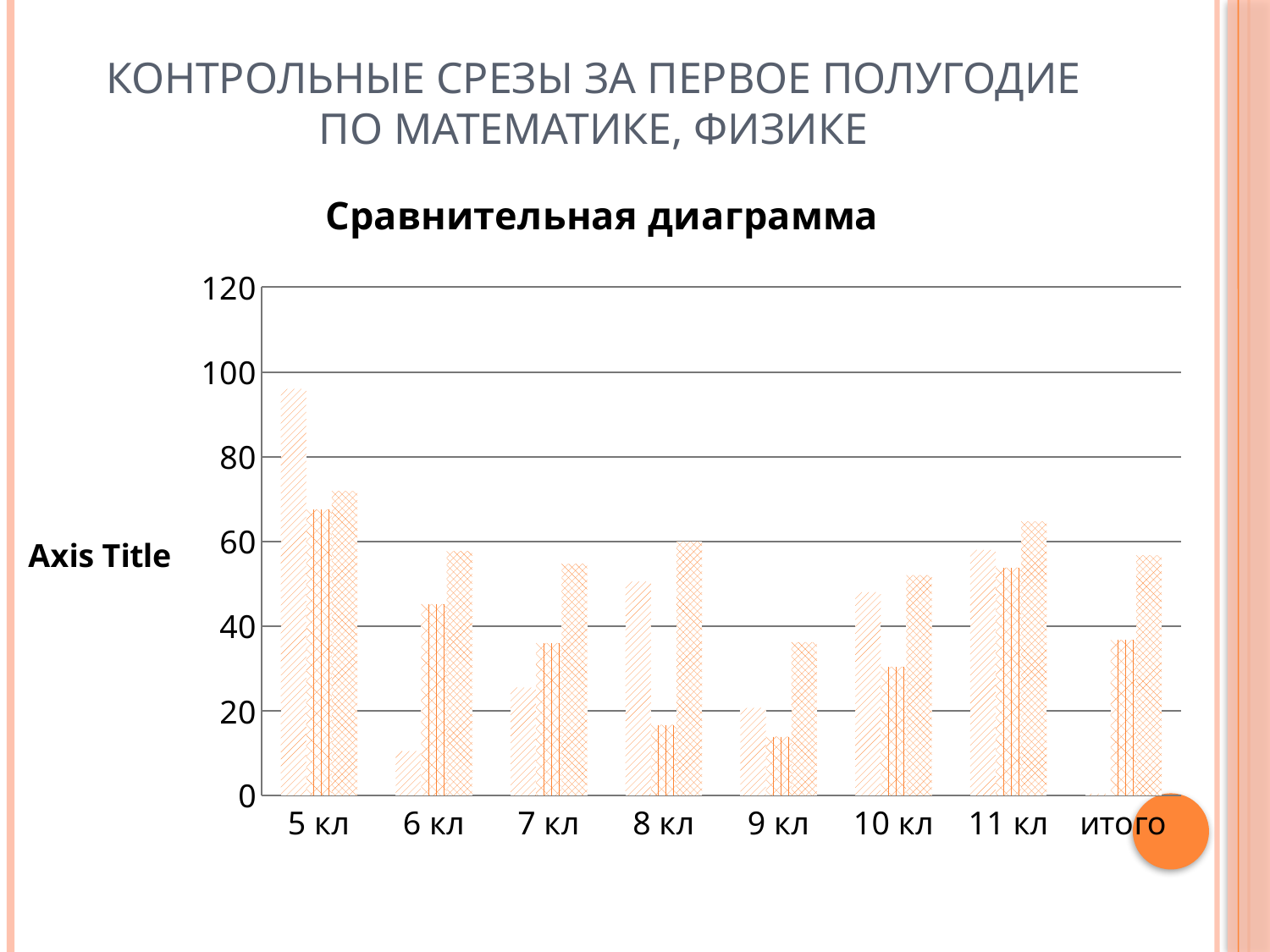
What is the label on the vertical axis of the chart? Axis Title How many categories are shown on the horizontal axis of the chart? 8 Is the value of the third (rightmost) bar for 11 кл greater or less than 60? greater Is the value of the third (rightmost) bar for 6 кл greater or less than 40? greater Is the value of the first (leftmost) bar for 6 кл greater or less than 20? less What is the title of the chart? Сравнительная диаграмма What kind of chart is shown on the slide? bar chart Which is larger: the first (leftmost) bar for 5 кл or the first (leftmost) bar for 11 кл? 5 кл Which is larger: the third (rightmost) bar for 8 кл or the third (rightmost) bar for 9 кл? 8 кл Which category contains the tallest bar in the chart? 5 кл